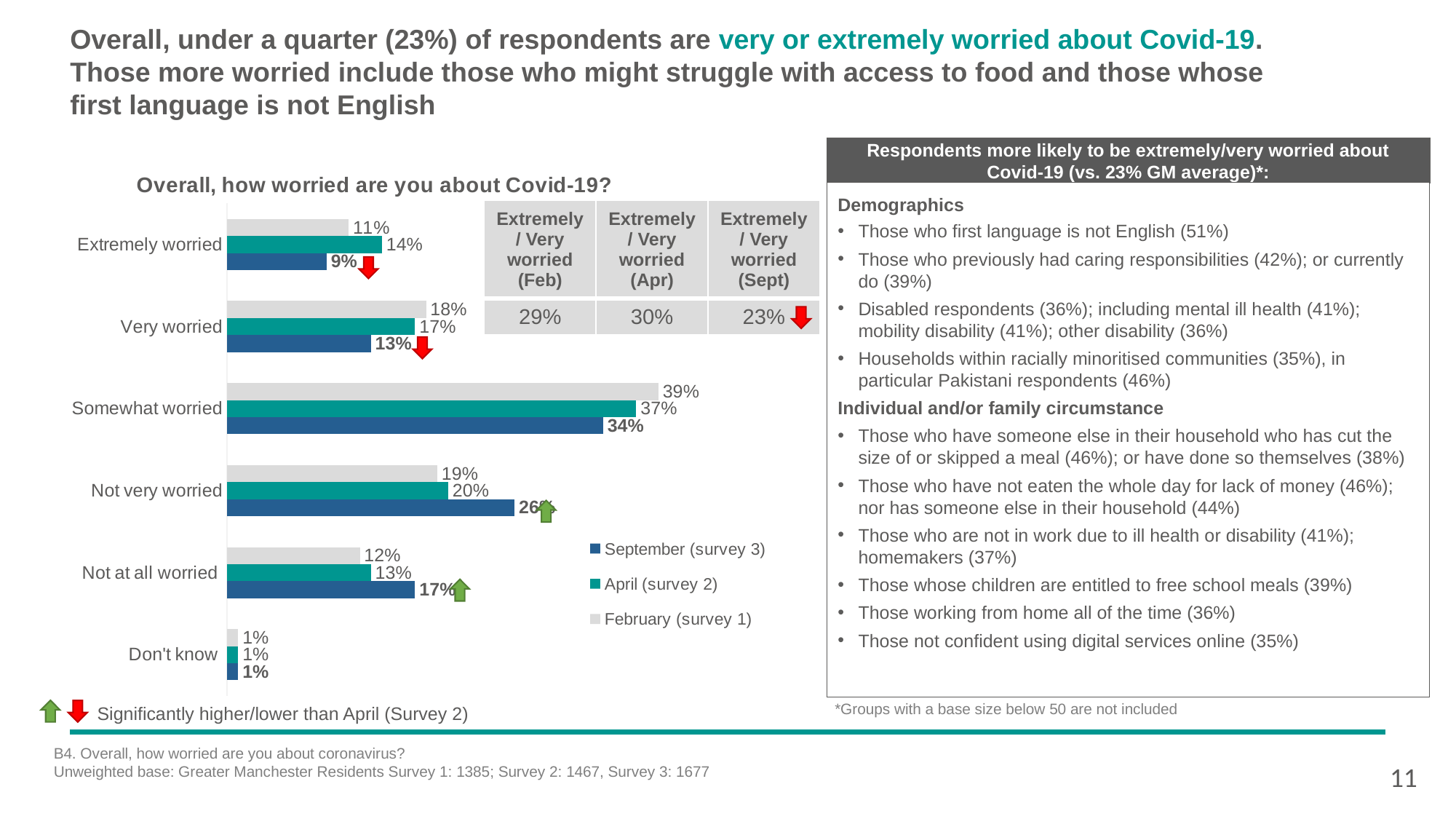
What is the April (survey 2) value for Not very worried? 20% Which is larger for Not at all worried: the September (survey 3) value or the April (survey 2) value? September (survey 3) What is the September (survey 3) value for Somewhat worried? 34% How many series does the legend list? 3 What is the February (survey 1) value for Extremely worried? 11% What kind of chart is shown? Bar chart What is the title of the chart? Overall, how worried are you about Covid-19? Which category has the lowest February (survey 1) value? Don't know What is the difference between the February (survey 1) and September (survey 3) values for Somewhat worried? 5% How many categories are shown on the chart? 6 Which category has the highest September (survey 3) value? Somewhat worried Which series is shown in dark blue in the legend? September (survey 3)